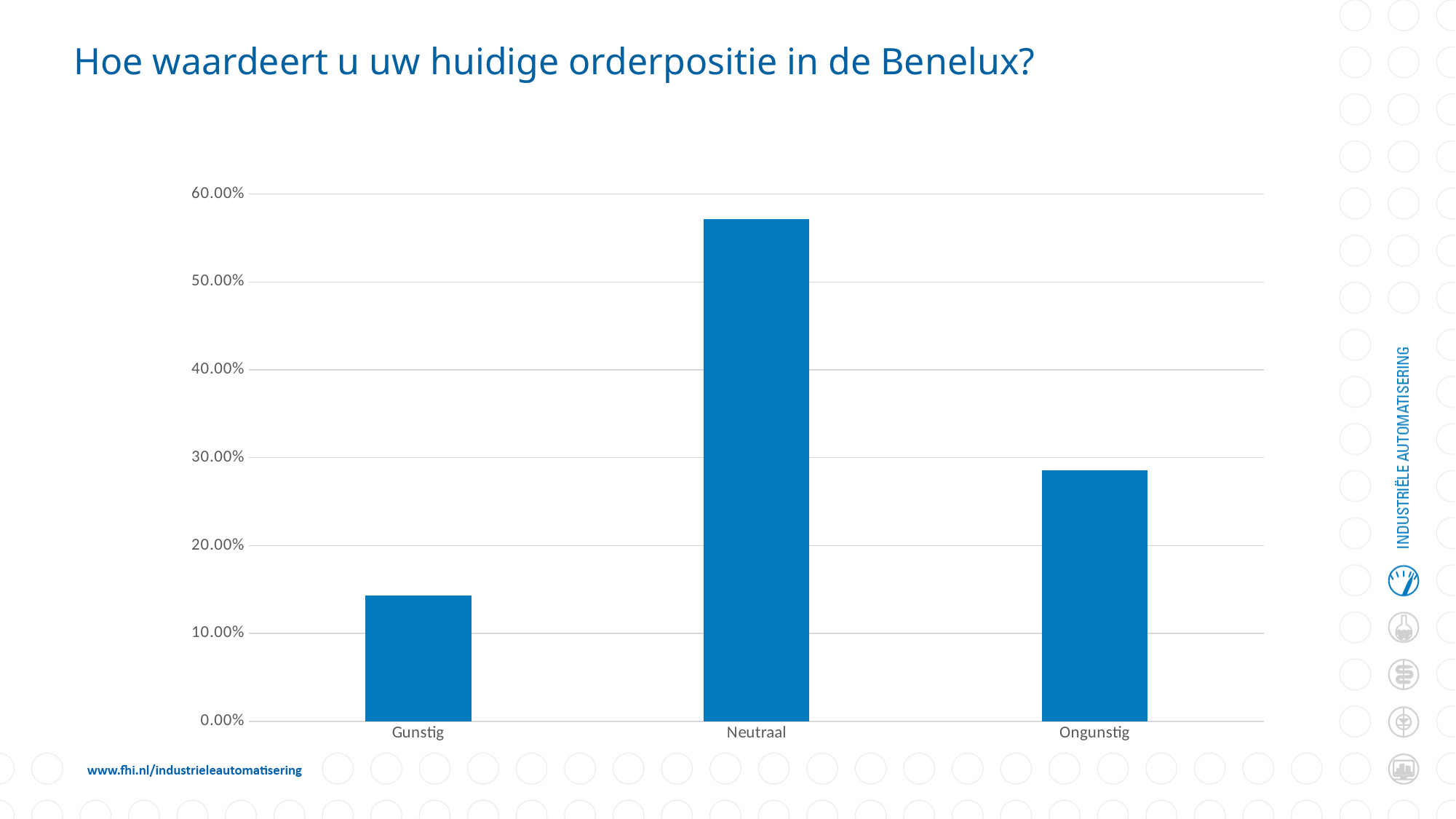
Is the value for Ongunstig greater or less than 30.00%? less Which is larger, the value for Ongunstig or the value for Gunstig? Ongunstig Which is larger, the value for Neutraal or the value for Ongunstig? Neutraal Which category has the lowest value? Gunstig What is the title of the chart? Hoe waardeert u uw huidige orderpositie in de Benelux? Which category has the highest value? Neutraal What kind of chart is shown on the slide? bar chart Is the value for Ongunstig greater or less than 20.00%? greater Is the value for Gunstig greater or less than 10.00%? greater How many categories are shown on the x axis? 3